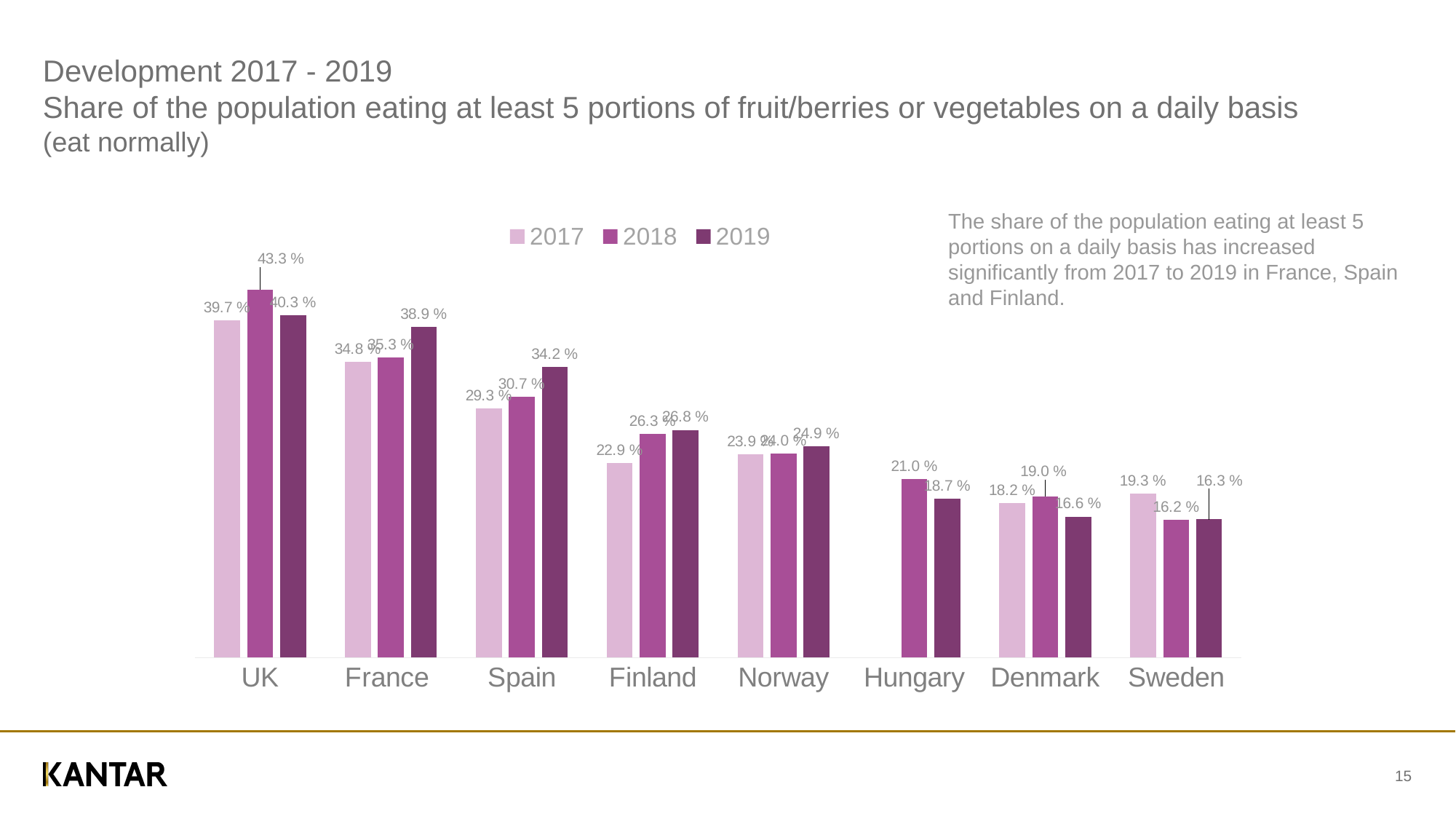
What is the value for the UK in 2018? 43.3 % What is the value for Spain in 2019? 34.2 % What is the value for Hungary in 2019? 18.7 % Which country has the highest value in 2019? UK Which country has the lowest value in 2018? Sweden Which is larger: France's 2019 value or Spain's 2019 value? France What is the value for Finland in 2017? 22.9 % How many series does the legend list? 3 Which country has no bar for 2017? Hungary How many countries are shown on the x axis? 8 What kind of chart is shown on the slide? Bar chart By how many percentage points did Spain's value increase from 2017 to 2019? 4.9 percentage points